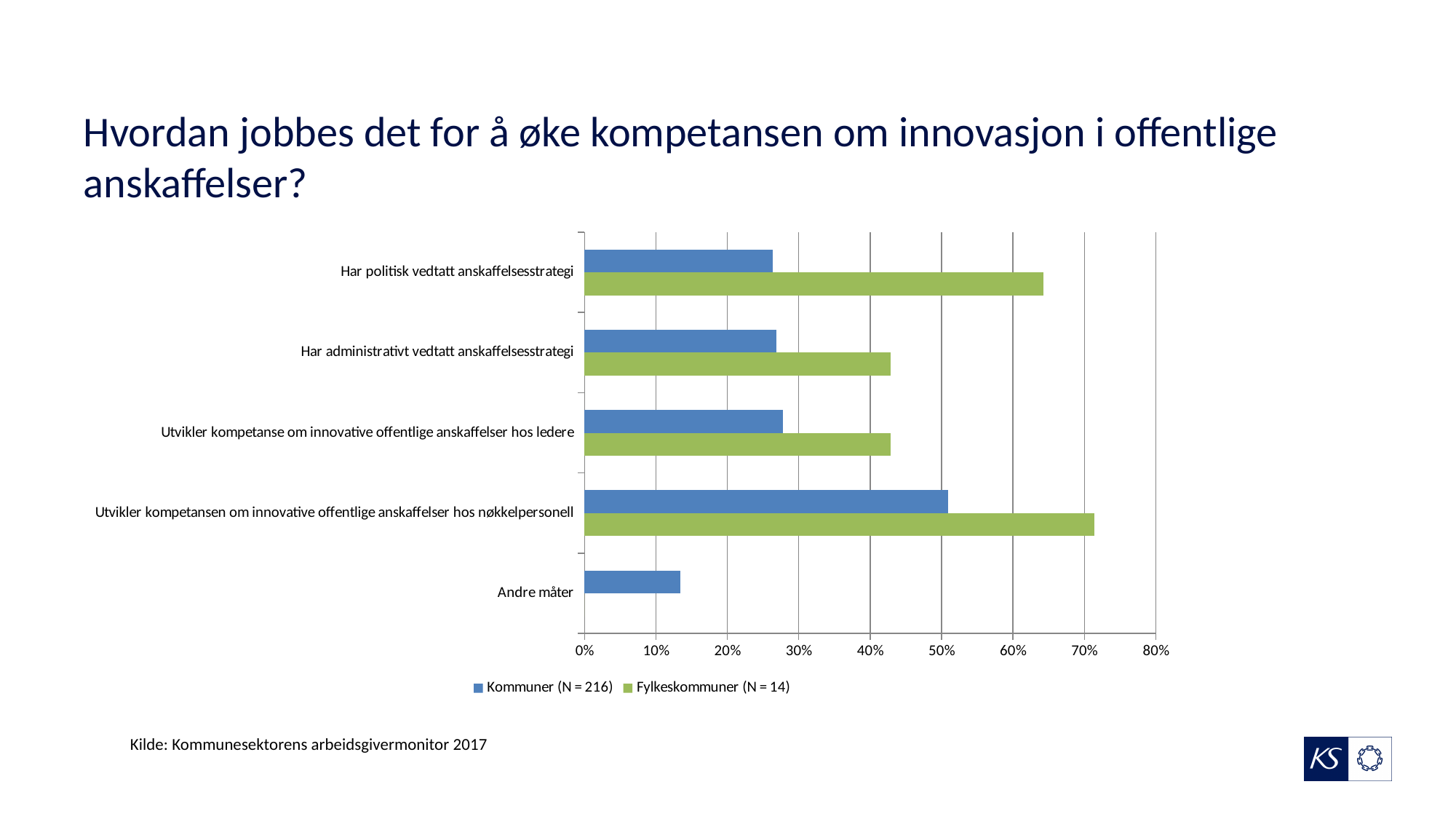
What colour are the bars for Fylkeskommuner (N = 14)? Green How many series does the legend list? 2 What kind of chart is shown on the slide? Bar chart Which category has the highest value for Kommuner (N = 216)? Utvikler kompetansen om innovative offentlige anskaffelser hos nøkkelpersonell How many categories are shown on the chart? 5 Is the value for Kommuner (N = 216) on 'Andre måter' greater or less than 20%? less Which category has the highest value for Fylkeskommuner (N = 14)? Utvikler kompetansen om innovative offentlige anskaffelser hos nøkkelpersonell Is the value for Kommuner (N = 216) on 'Har politisk vedtatt anskaffelsesstrategi' greater or less than 30%? less Is the value for Fylkeskommuner (N = 14) on 'Har politisk vedtatt anskaffelsesstrategi' greater or less than 60%? greater Which category has the lowest value for Kommuner (N = 216)? Andre måter For 'Har politisk vedtatt anskaffelsesstrategi', which series has the larger value, Kommuner (N = 216) or Fylkeskommuner (N = 14)? Fylkeskommuner (N = 14)